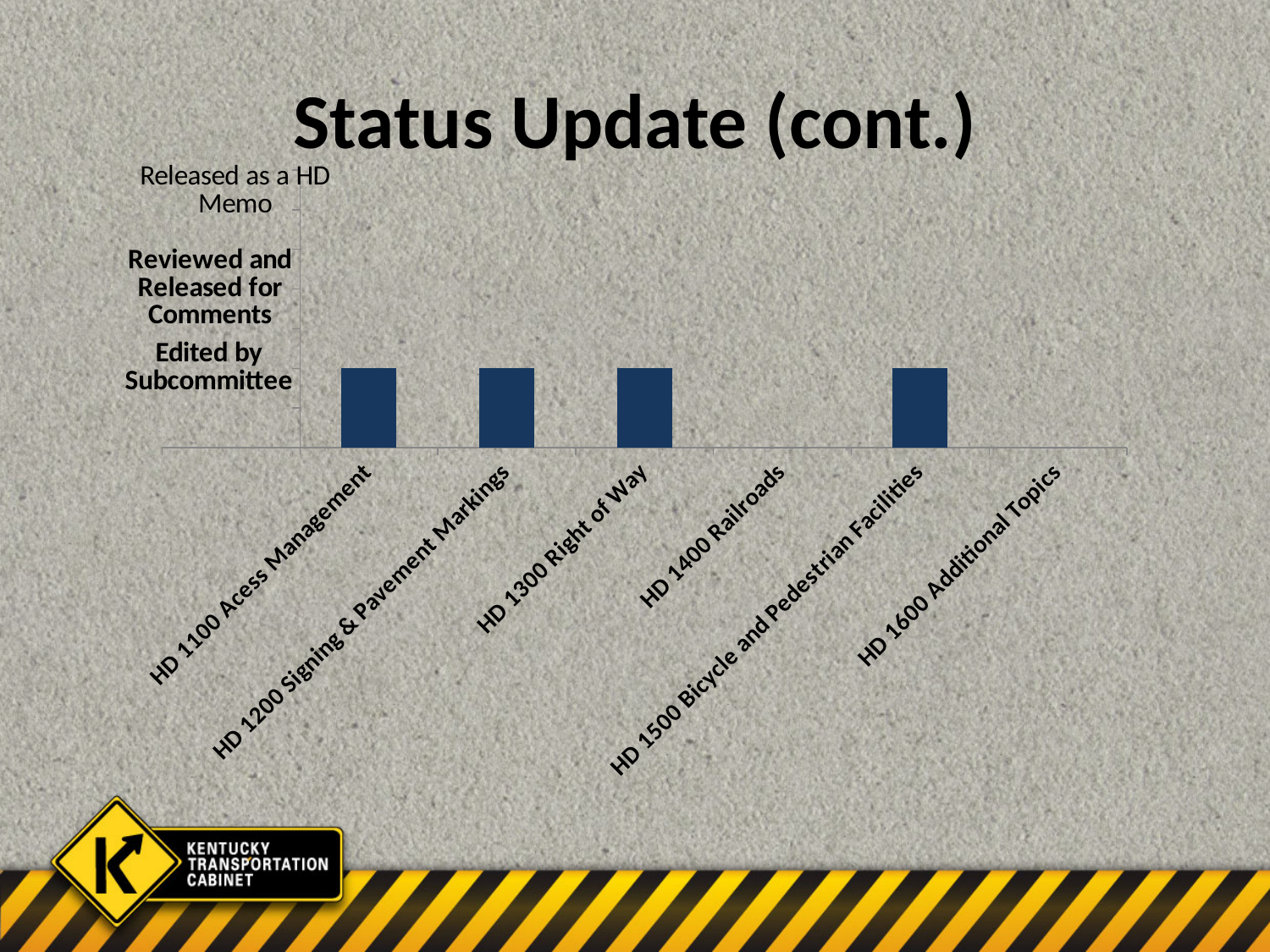
Which status level does the bar for HD 1300 Right of Way reach? Edited by Subcommittee Which status level does the bar for HD 1500 Bicycle and Pedestrian Facilities reach? Edited by Subcommittee Does any bar reach the 'Reviewed and Released for Comments' level? No What is the title of the slide containing the chart? Status Update (cont.) How many categories have a visible bar in the chart? 4 How many categories are listed along the x axis of the chart? 6 Which categories have no bar shown in the chart? HD 1400 Railroads and HD 1600 Additional Topics Does any bar reach the 'Released as a HD Memo' level? No What kind of chart is shown on the slide? Bar chart Is the bar for HD 1200 Signing & Pavement Markings taller than the bar for HD 1400 Railroads? Yes What is the highest status level labelled on the y axis? Released as a HD Memo Which status level does the bar for HD 1100 Acess Management reach? Edited by Subcommittee